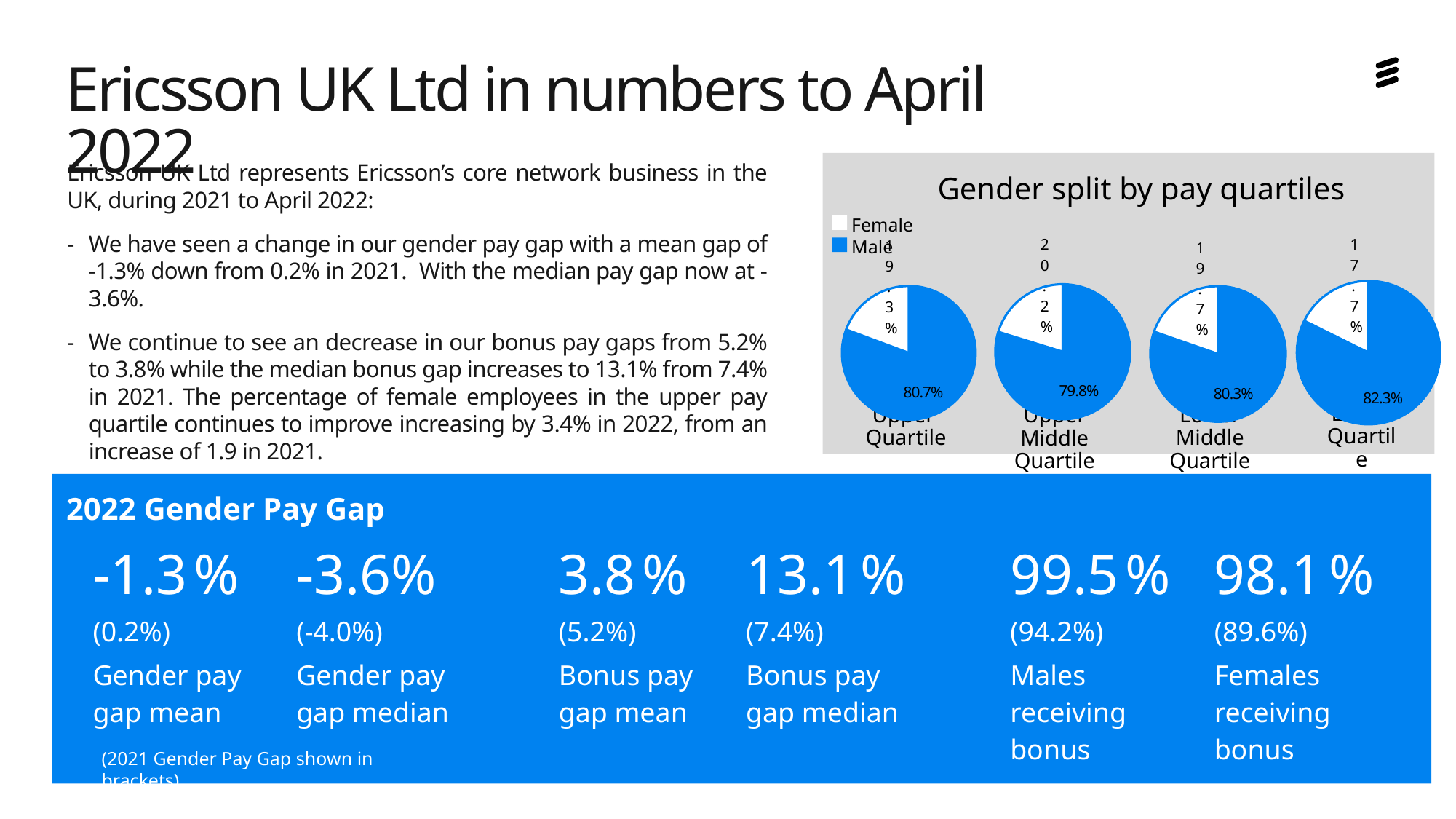
In the 'Gender split by pay quartiles' chart, what is the Male share in the Upper Quartile pie? 80.7% In the 'Gender split by pay quartiles' chart, what is the Male share in the Lower Quartile pie? 82.3% How many entries does the legend of the 'Gender split by pay quartiles' chart list? 2 What kind of chart is used in the 'Gender split by pay quartiles' chart? Pie chart How many pie charts are shown in the 'Gender split by pay quartiles' chart? 4 In the 'Gender split by pay quartiles' chart, what is the Male share in the Lower Middle Quartile pie? 80.3% In the 'Gender split by pay quartiles' chart, which quartile has the highest Male share? Lower Quartile In the 'Gender split by pay quartiles' chart, which quartile has the lowest Male share? Upper Middle Quartile In the 'Gender split by pay quartiles' chart, is the Male share larger in the Lower Quartile or the Upper Quartile? Lower Quartile In the 'Gender split by pay quartiles' chart, what is the Male share in the Upper Middle Quartile pie? 79.8% In the 'Gender split by pay quartiles' chart, what is the Female share in the Upper Middle Quartile pie? 20.2% In the 'Gender split by pay quartiles' chart, what is the difference between the Male share in the Lower Quartile and the Upper Middle Quartile? 2.5%